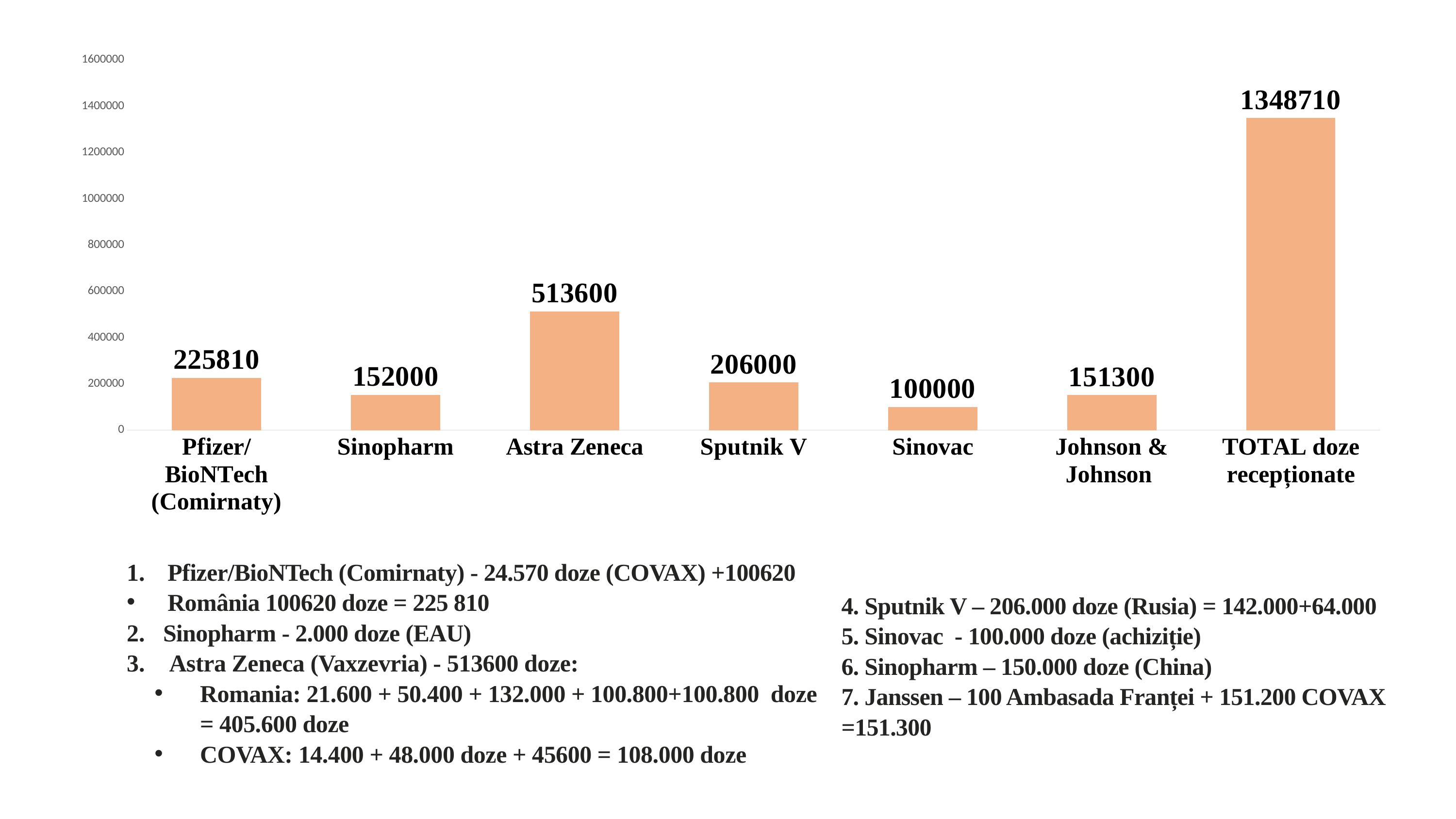
Which category has the lowest value in the chart? Sinovac What value is shown for Johnson & Johnson? 151300 Which is larger, the value for Sinopharm or the value for Johnson & Johnson? Sinopharm How many bars are shown in the chart? 7 What type of chart is shown on the slide? bar chart Excluding the TOTAL bar, which vaccine has the highest number of doses? Astra Zeneca What value is shown for Astra Zeneca? 513600 Is the value for Pfizer/BioNTech (Comirnaty) greater or less than 200000? greater What is the difference between the values for Pfizer/BioNTech (Comirnaty) and Sinopharm? 73810 What value is shown for TOTAL doze recepționate? 1348710 What is the difference between the values for Astra Zeneca and Sputnik V? 307600 What value is shown for Sputnik V? 206000